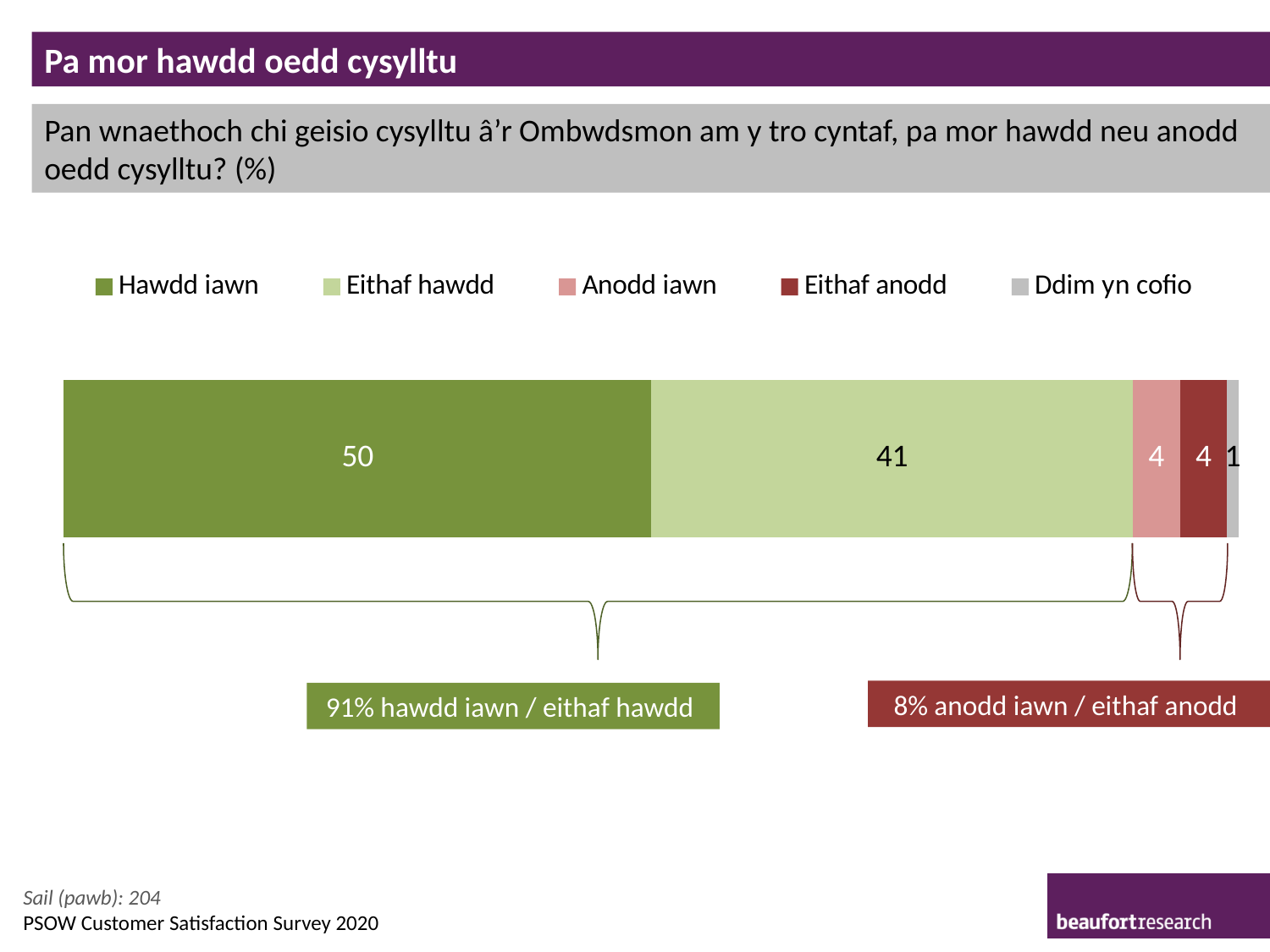
Which segment of the bar has the highest value? Hawdd iawn What is the total of all segments in the stacked bar? 100 What is the difference between the values for Hawdd iawn and Eithaf hawdd? 9 What value is shown for Eithaf hawdd? 41 What kind of chart is shown on the slide? Stacked bar chart What value is shown for Anodd iawn? 4 Which segment of the bar has the lowest value? Ddim yn cofio What colour is the Hawdd iawn segment in the legend? Green How many series does the legend list? 5 What value is shown for Hawdd iawn? 50 Which is larger, the value for Eithaf hawdd or the value for Eithaf anodd? Eithaf hawdd What value is shown for Ddim yn cofio? 1